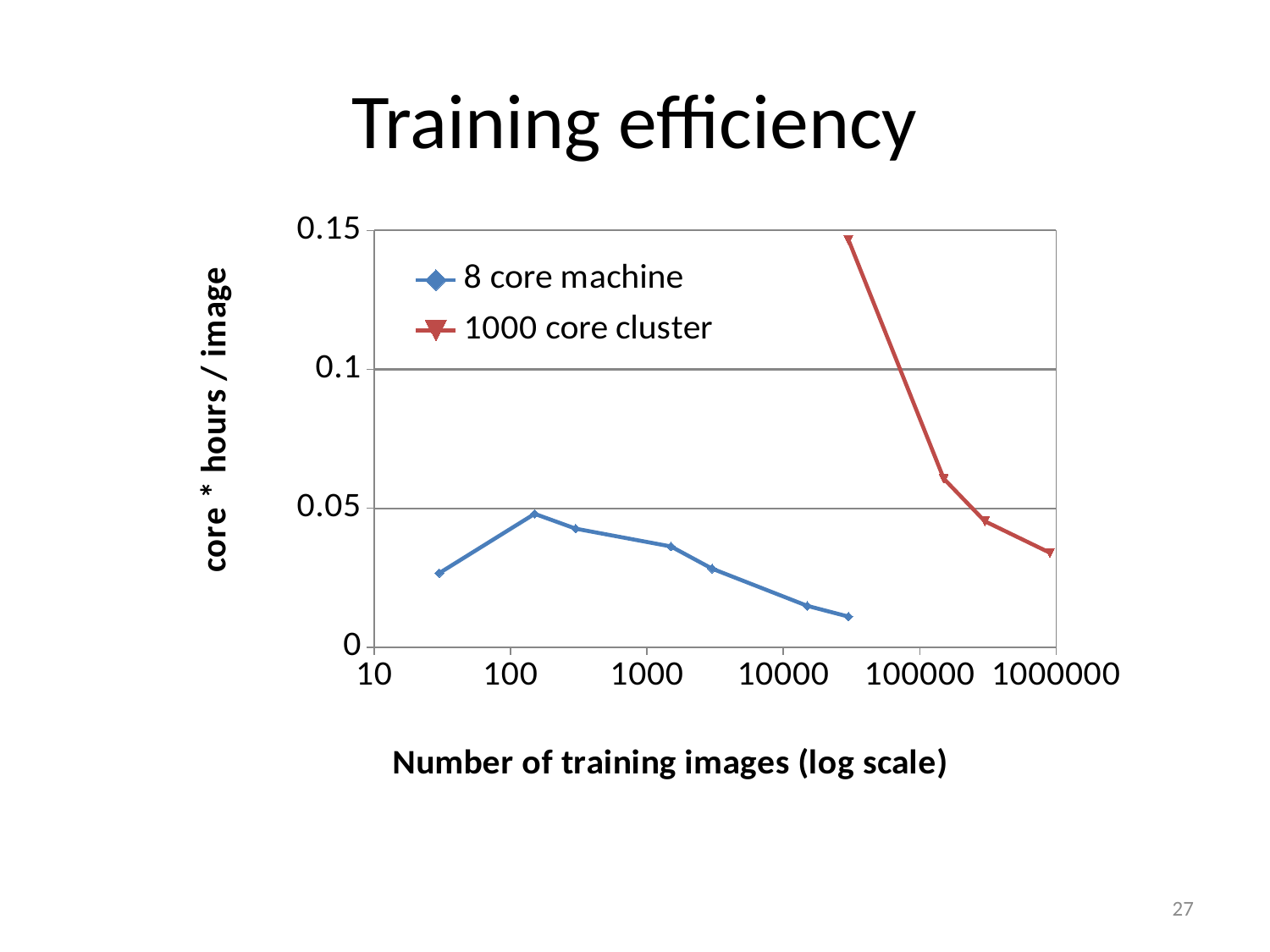
Is the highest value of the 1000 core cluster series greater or less than 0.1? greater What is the title of the chart's x axis? Number of training images (log scale) How many data points are plotted for the 1000 core cluster series? 4 Is the value for the 1000 core cluster at 1000000 training images greater or less than 0.05? less How many series does the legend list? 2 What kind of chart is shown on the slide? line chart Do the values for the 1000 core cluster series rise or fall as the number of training images increases? fall How many data points are plotted for the 8 core machine series? 7 Which series reaches the highest value on the chart? 1000 core cluster At around 30000 training images, which series has the larger value: 8 core machine or 1000 core cluster? 1000 core cluster Is the value for the 8 core machine at its last point (around 30000 images) greater or less than 0.05? less What colour is the line for the 8 core machine series? blue